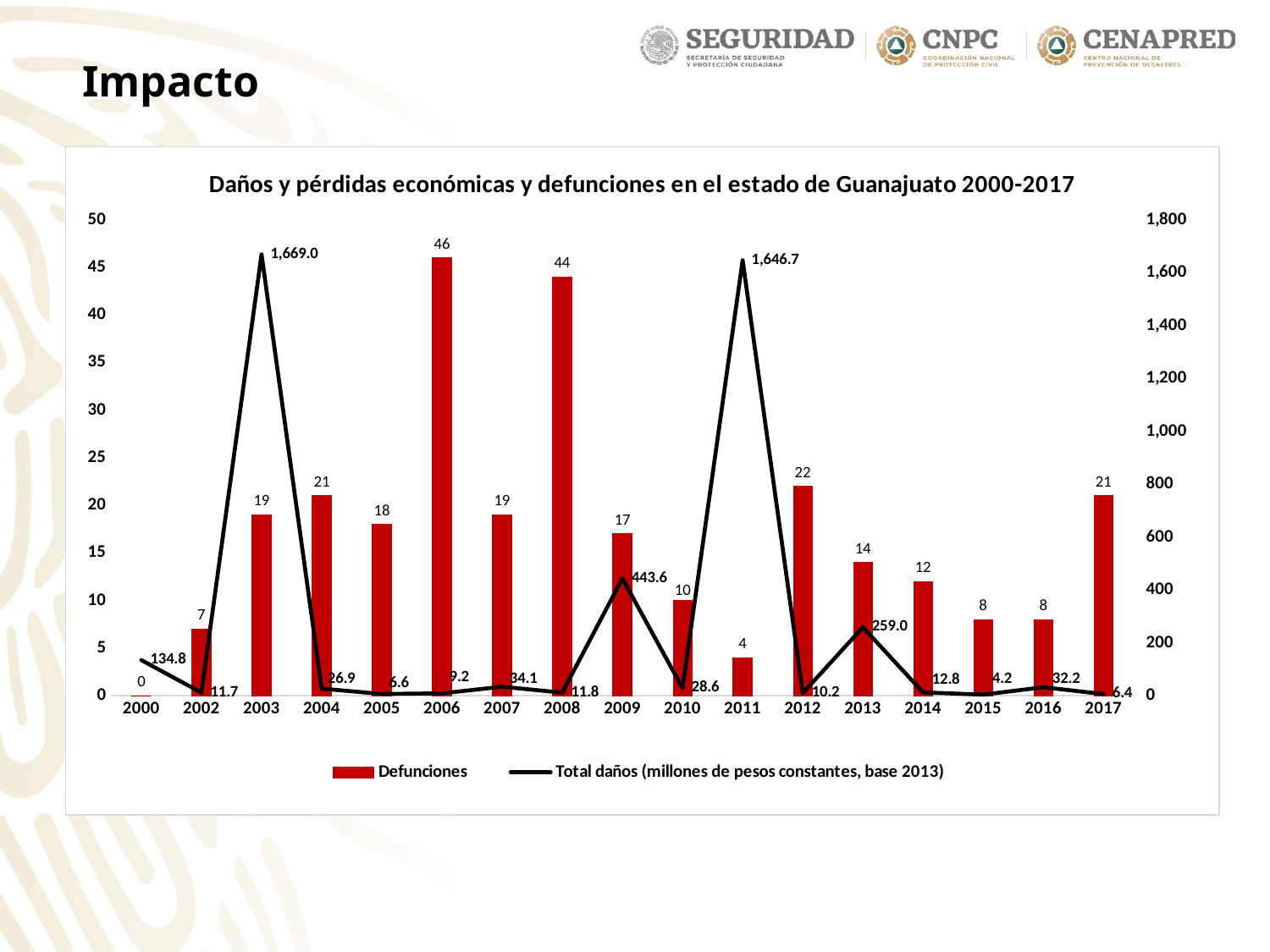
Which year has more Defunciones, 2004 or 2013? 2004 Which year has the highest number of Defunciones? 2006 What is the difference in Defunciones between 2008 and 2012? 22 How many years are shown on the x axis? 17 What is the number of Defunciones in 2006? 46 How many series does the legend list? 2 Which year has the lowest number of Defunciones? 2000 What colour are the Defunciones bars? Red What is the Total daños value for 2011? 1,646.7 What is the title of the chart? Daños y pérdidas económicas y defunciones en el estado de Guanajuato 2000-2017 What is the Total daños value for 2009? 443.6 Which year has the highest Total daños value? 2003